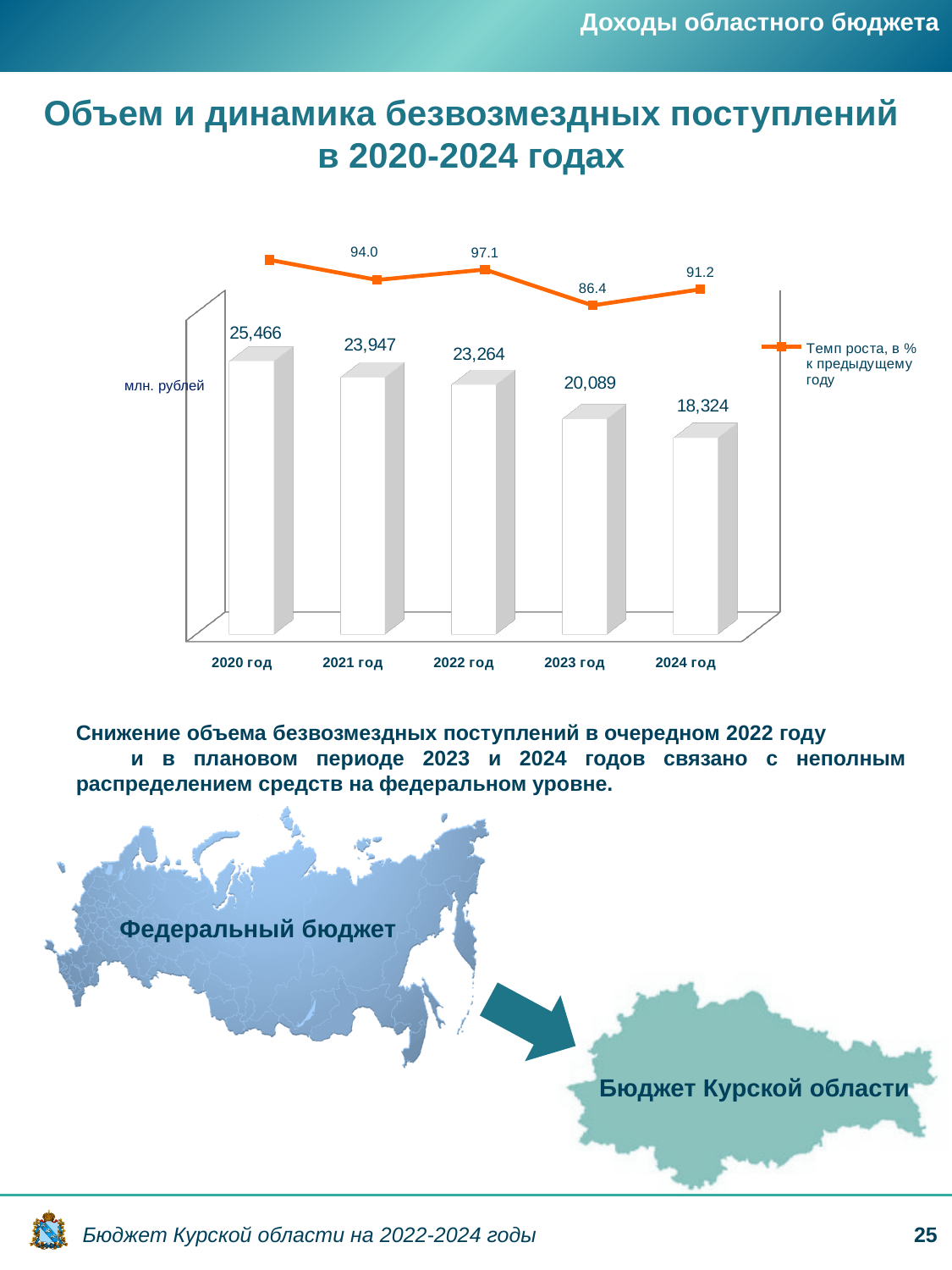
What is the difference between the gratuitous receipts for 2020 год and 2024 год? 7,142 Which year has the lowest value of gratuitous receipts? 2024 год Which year has the highest value of gratuitous receipts? 2020 год How many years are shown on the x axis of the chart? 5 What is the growth rate (Темп роста, в % к предыдущему году) shown for 2023 год? 86.4 Do the gratuitous receipts rise or fall from 2020 год to 2024 год? Fall What is the growth rate (Темп роста, в % к предыдущему году) shown for 2022 год? 97.1 Which is larger: the gratuitous receipts for 2021 год or for 2022 год? 2021 год What is the value of gratuitous receipts (млн. рублей) for 2020 год? 25,466 What is the value of gratuitous receipts (млн. рублей) for 2024 год? 18,324 What kind of chart is used to show the gratuitous receipts in млн. рублей? Bar chart How many entries does the chart legend list? 1